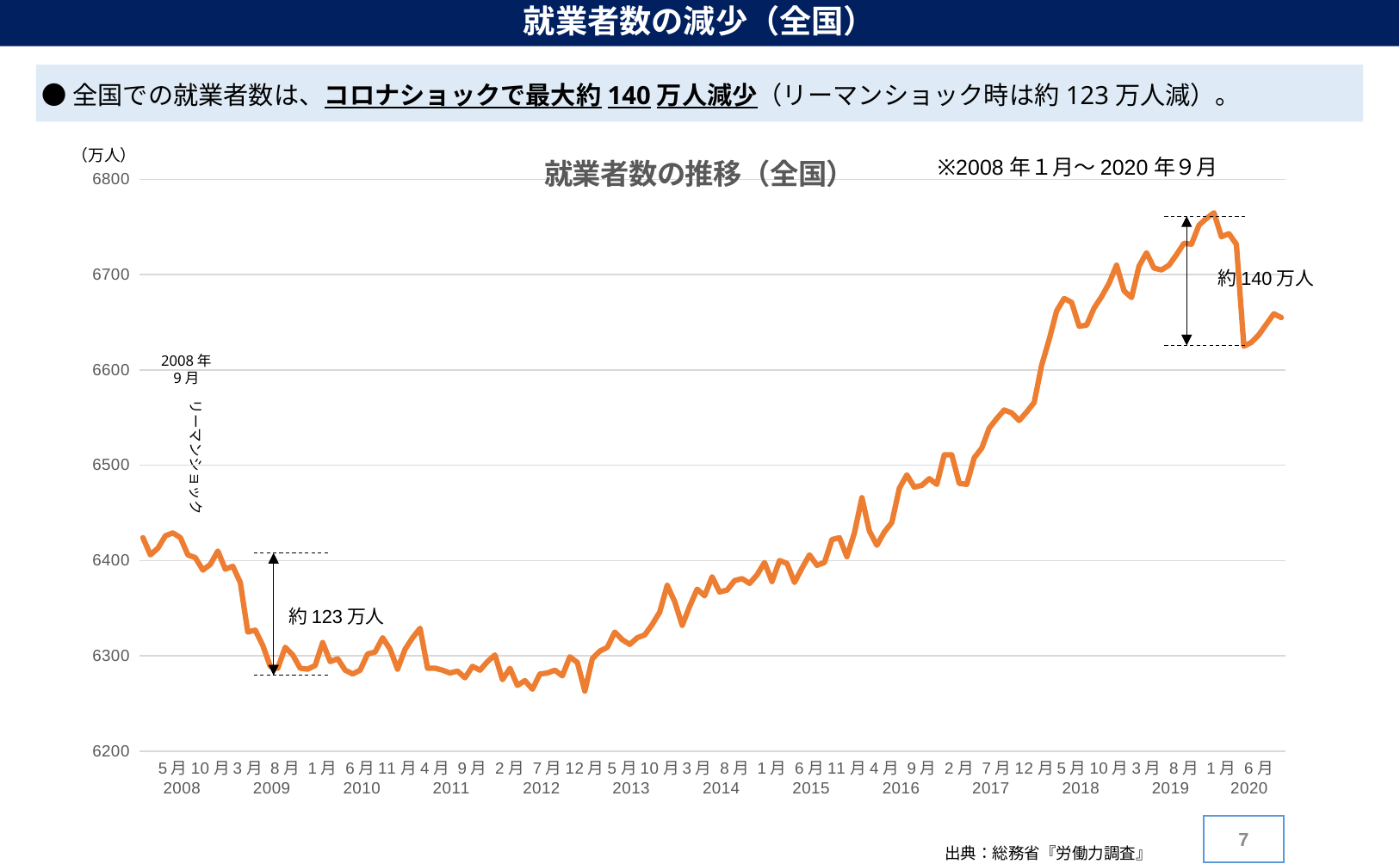
What unit is shown on the vertical axis of the chart? 万人 What is the title of the chart? 就業者数の推移（全国） According to the annotation on the chart, by about how much did the number of employed persons fall after the Lehman shock? 約123万人 Is the peak value of the line in 2019 greater or less than 6700? greater What kind of chart is shown on the slide? line chart According to the annotation on the chart, by about how much did the number of employed persons fall during the Corona shock? 約140万人 What is the highest tick value shown on the vertical axis? 6800 Which annotated decline is larger, the Lehman shock decline or the Corona shock decline? Corona shock decline (約140万人) Overall, does the line rise or fall between 2012 and 2019? rise How many data series are plotted in the chart? 1 Is the value of the line in mid-2014 greater or less than 6400? less Is the value of the line in early 2012 greater or less than 6300? less